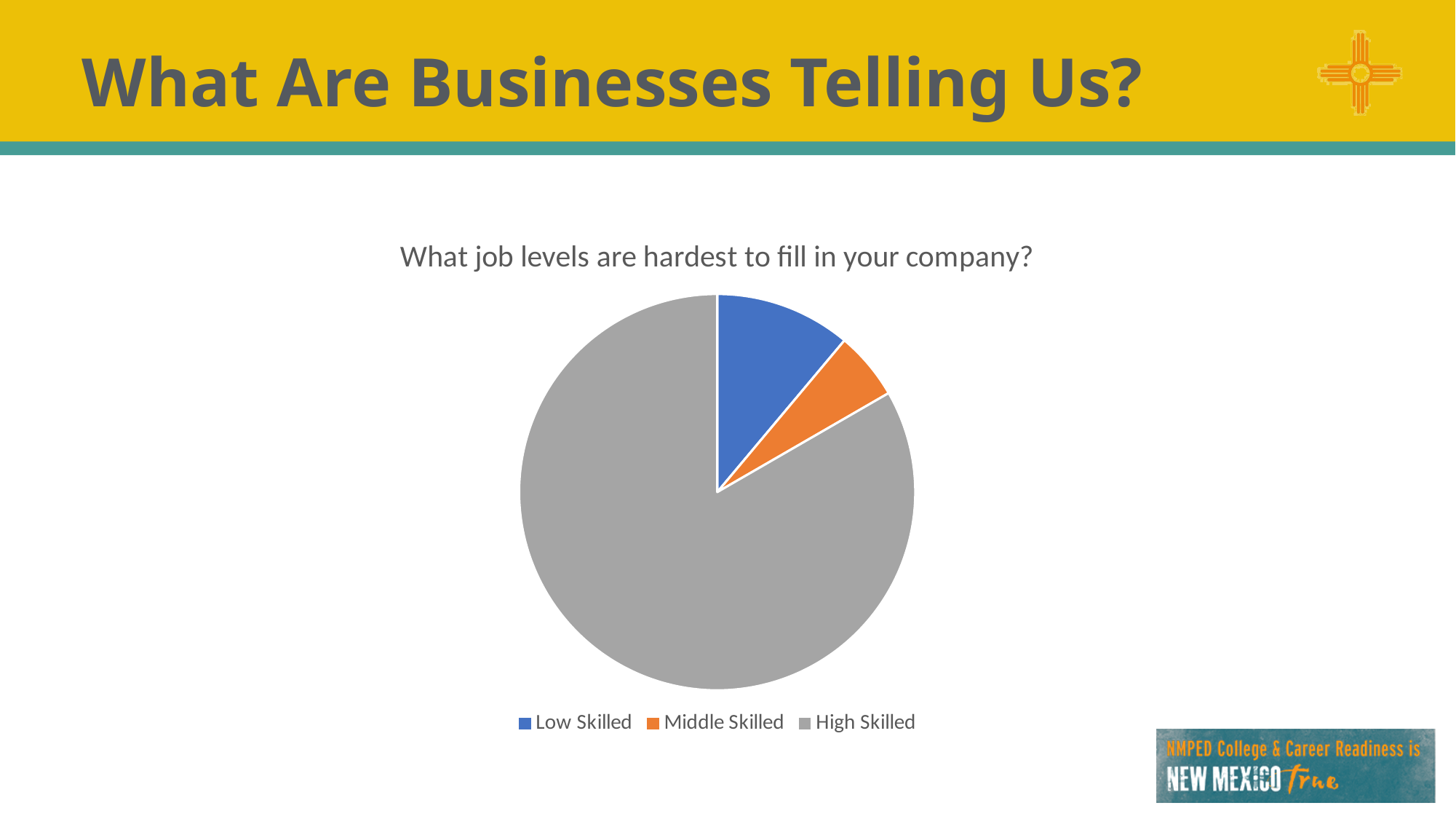
Which job level has the largest slice of the pie? High Skilled How many entries does the legend list? 3 Which colour represents High Skilled in the pie chart? gray Which slice is larger, High Skilled or Low Skilled? High Skilled Which slice is larger, Low Skilled or Middle Skilled? Low Skilled Which job level has the smallest slice of the pie? Middle Skilled What kind of chart is shown on the slide? pie chart What is the title of the chart? What job levels are hardest to fill in your company? How many categories does the pie chart show? 3